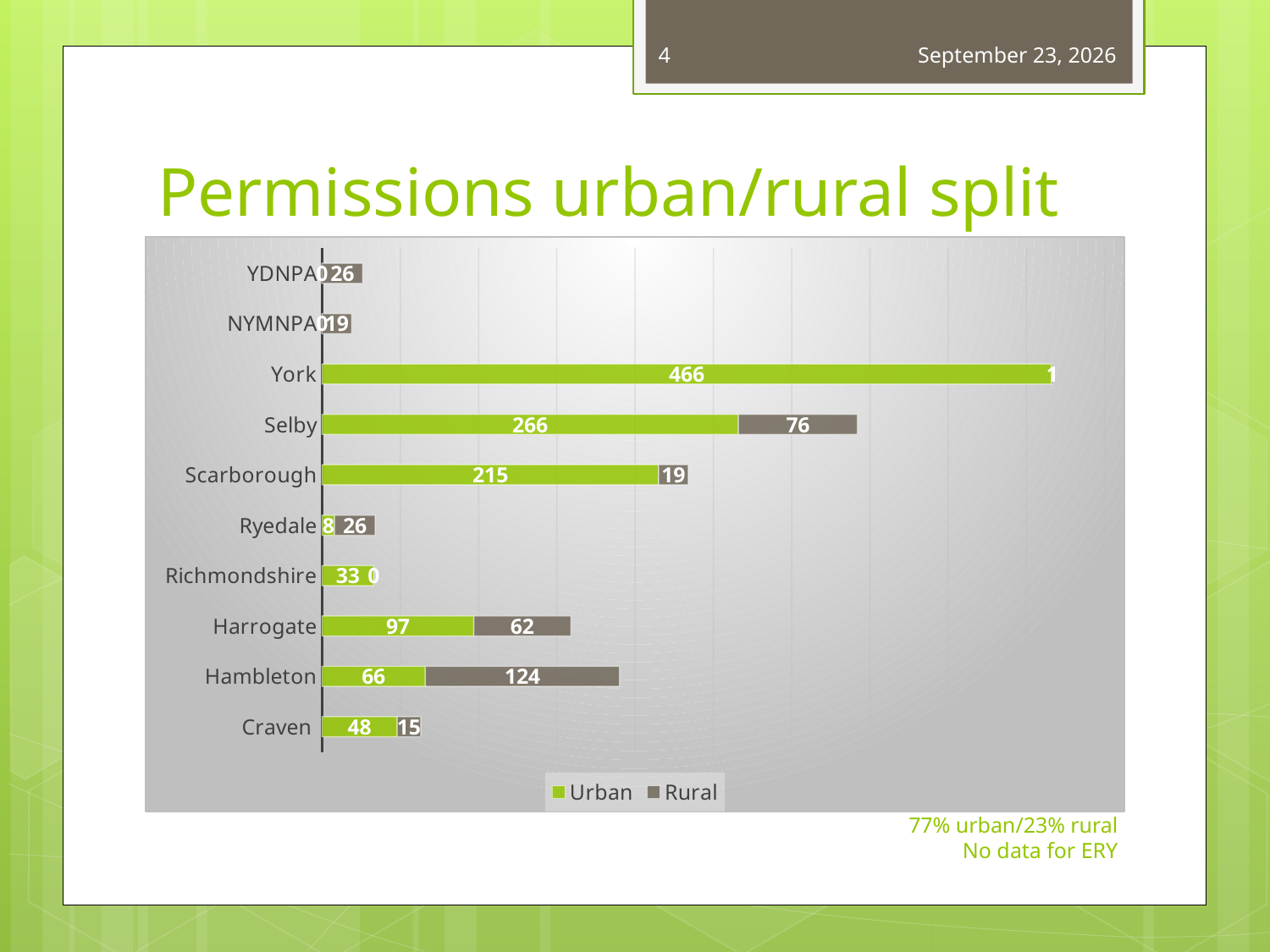
What is the Urban value for York? 466 What is the difference between the Urban and Rural values for Harrogate? 35 Which category has the highest Urban value? York How many categories are shown on the chart? 10 What is the Rural value for Hambleton? 124 What is the total of the stacked bar for Selby? 342 What is the Rural value for Selby? 76 What kind of chart is shown on the slide? Stacked bar chart How many series does the legend list? 2 Which is larger, the Urban value for Selby or the Urban value for Scarborough? Selby What is the Urban value for Scarborough? 215 Which category has the highest Rural value? Hambleton